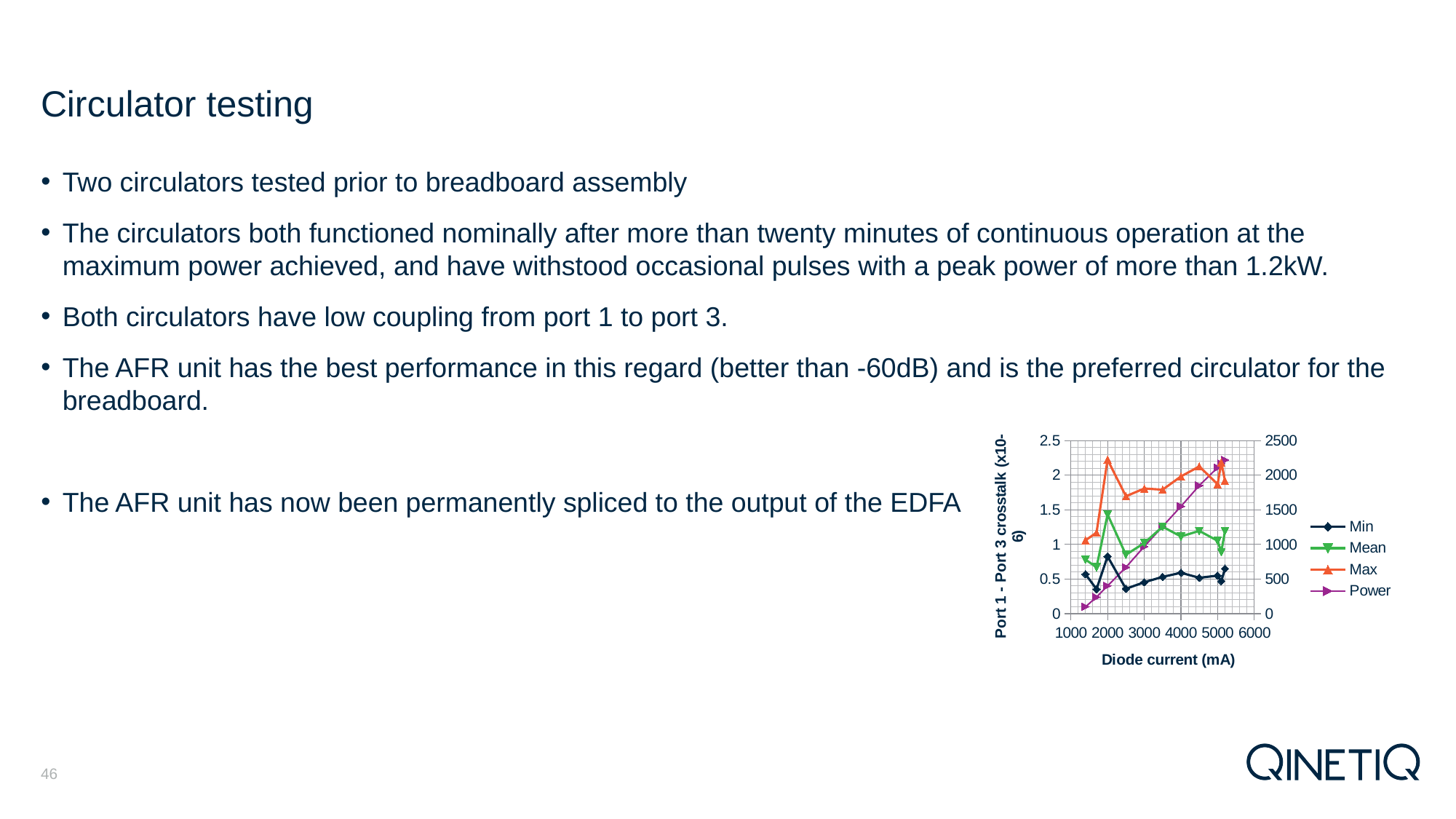
Is the Max value at 2000 mA greater or less than 2 on the left axis? greater Which series has the lowest crosstalk values on the left axis? Min Does the Power series rise or fall as diode current increases? rises What is the x-axis title of the chart? Diode current (mA) Is the Min value at 2000 mA greater or less than 1 on the left axis? less At 4000 mA, is the Mean crosstalk value larger or smaller than the Min crosstalk value? larger What are the series names listed in the chart legend? Min, Mean, Max, Power What kind of chart is shown on the slide? line chart Is the Mean value at 2000 mA greater or less than 1 on the left axis? greater Which series has the highest crosstalk values across the diode current range, Max or Min? Max How many series does the chart legend list? 4